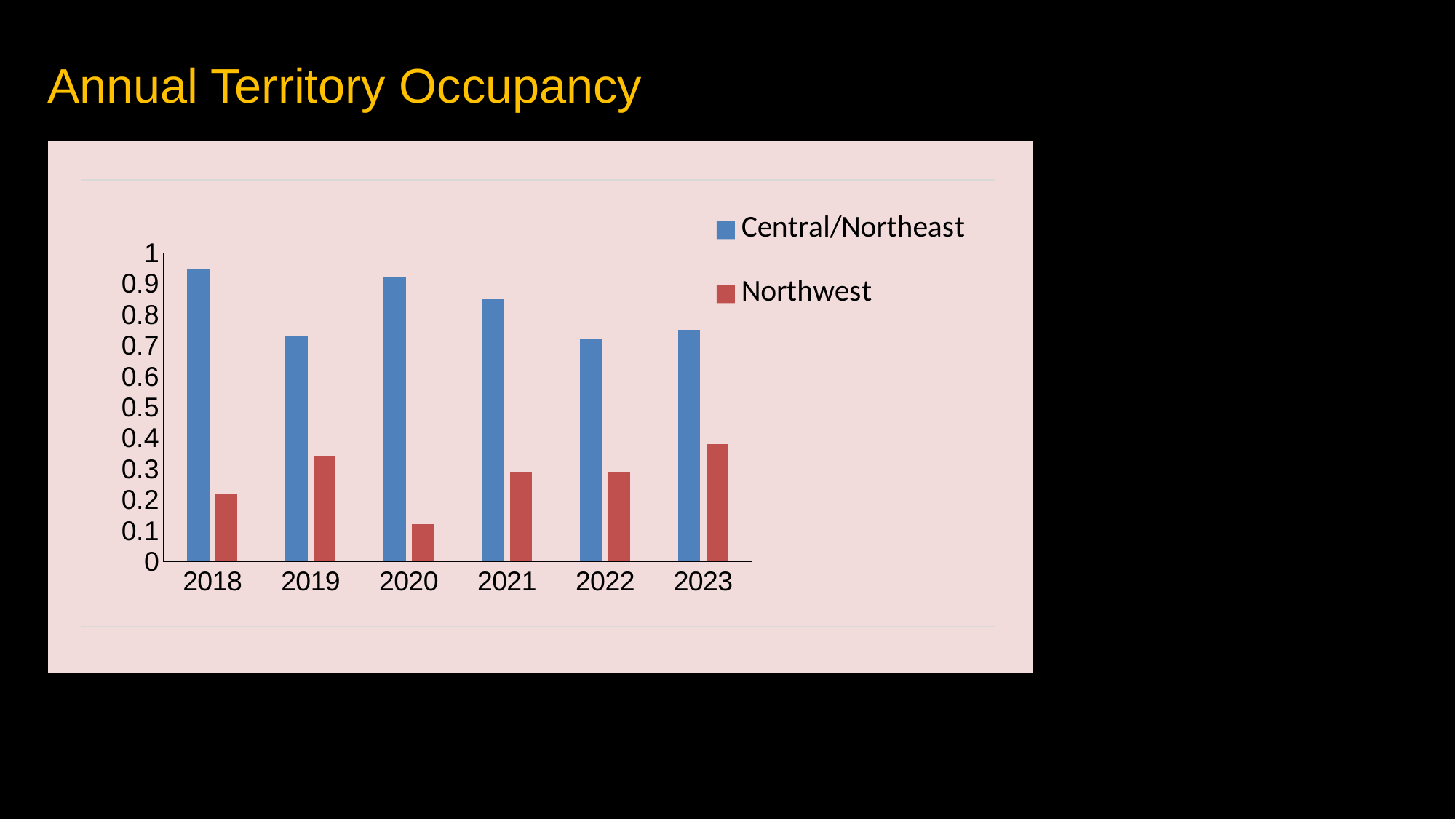
Is the Northwest value for 2020 greater or less than 0.2? less What is the title of the slide? Annual Territory Occupancy For the Northwest series, which year has the larger value, 2019 or 2020? 2019 How many series does the legend list? 2 Is the Central/Northeast value for 2021 greater or less than 0.8? greater In 2018, which series has the larger value, Central/Northeast or Northwest? Central/Northeast Which year has the lowest Northwest value? 2020 How many years are shown on the x axis? 6 Which year has the highest Northwest value? 2023 What type of chart is shown on the slide? Bar chart Is the Central/Northeast value for 2018 greater or less than 0.9? greater